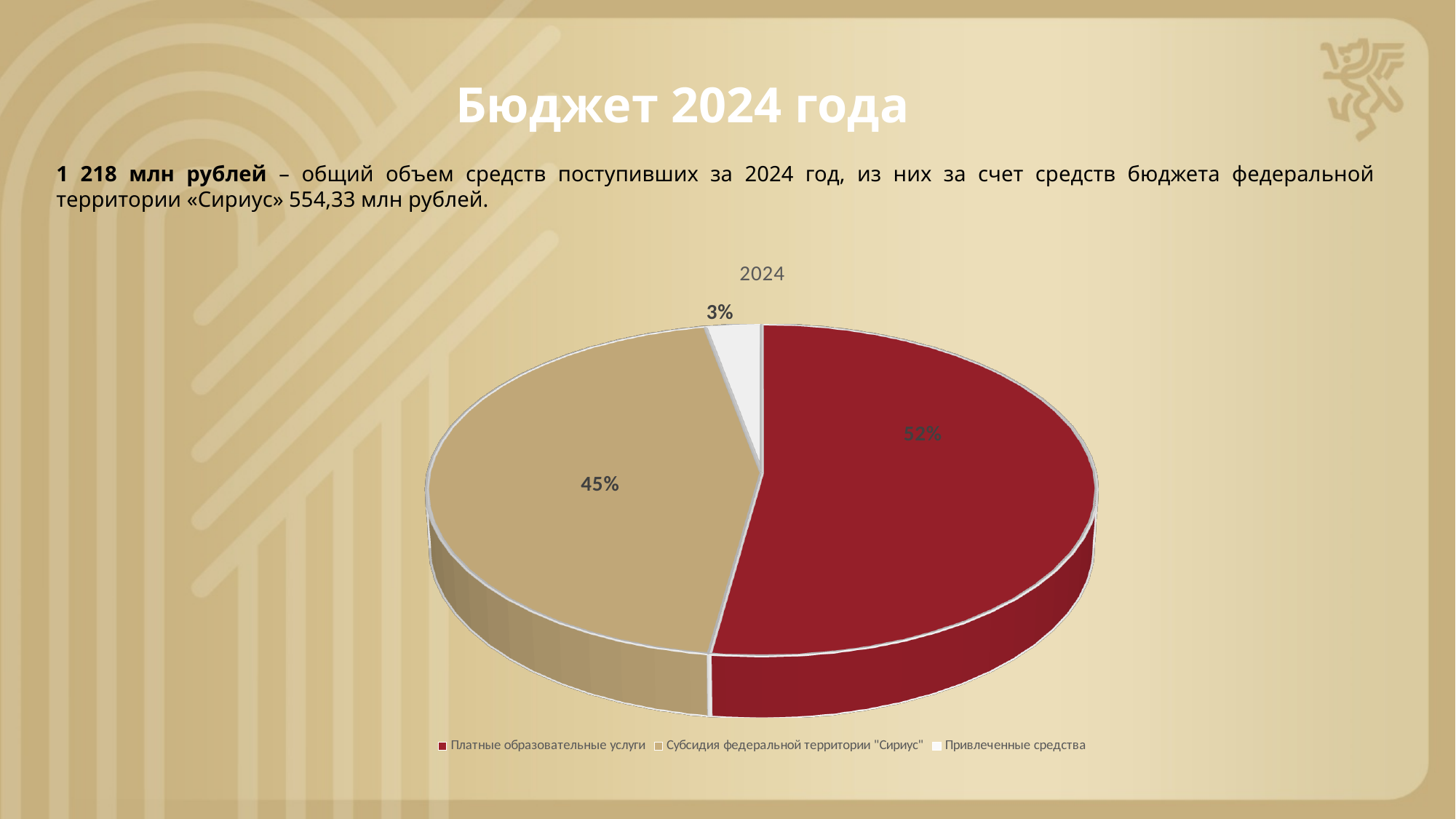
Which category has the smallest share of the pie? Привлеченные средства What share of the pie is Платные образовательные услуги? 52% What is the difference in percentage points between Платные образовательные услуги and Субсидия федеральной территории "Сириус"? 7 percentage points How many slices does the pie chart have? 3 What is the title of the chart? 2024 How many entries does the legend list? 3 Which category has the largest share of the pie? Платные образовательные услуги What share of the pie is Привлеченные средства? 3% What kind of chart is shown on the slide? Pie chart What colour is the slice for Платные образовательные услуги? Red Which is larger: the share for Субсидия федеральной территории "Сириус" or the share for Привлеченные средства? Субсидия федеральной территории "Сириус" What share of the pie is Субсидия федеральной территории "Сириус"? 45%